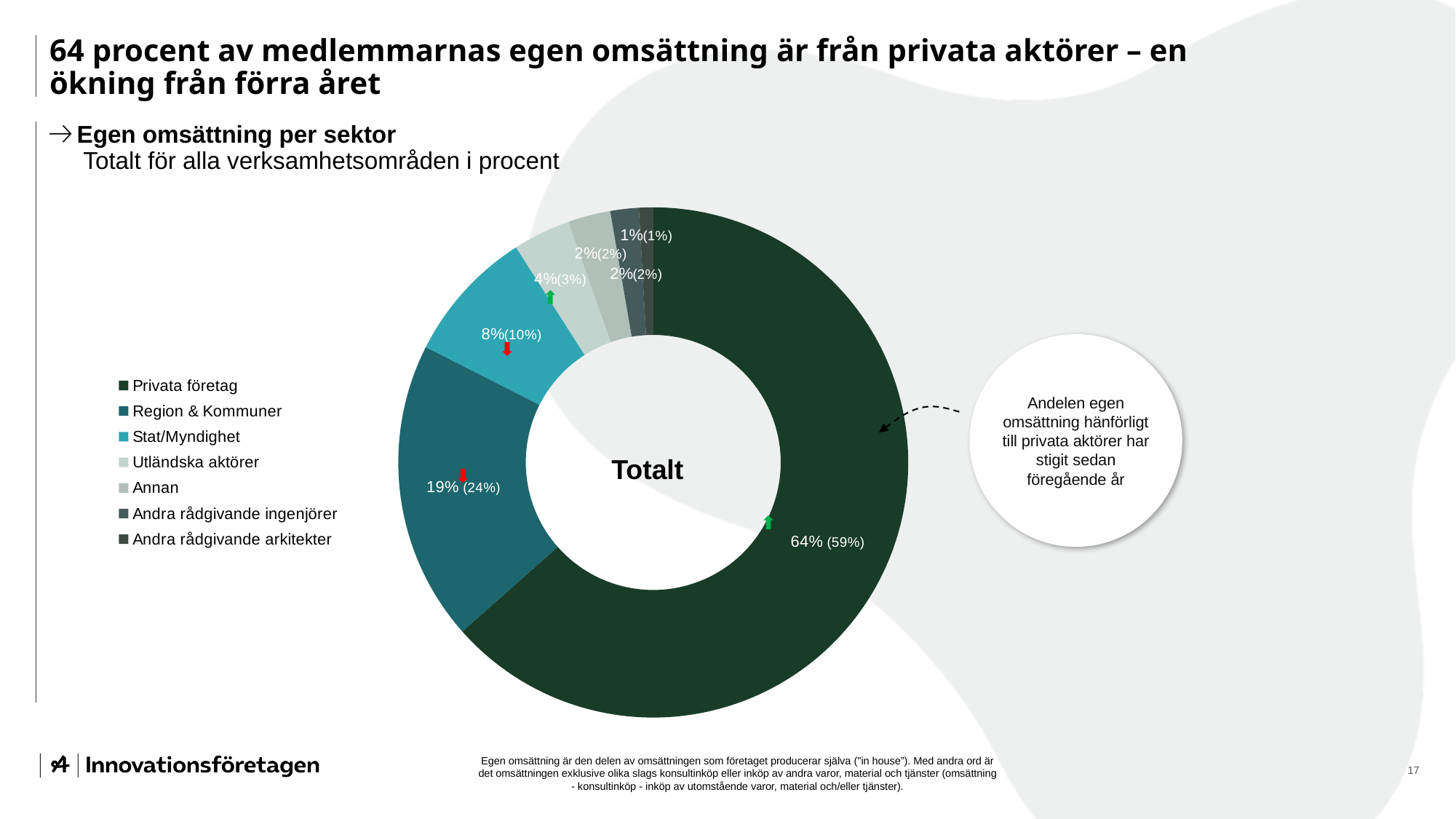
What share of egen omsättning comes from Utländska aktörer? 4% Which sector has the smallest share of egen omsättning? Andra rådgivande arkitekter What was the previous year's share for Privata företag, shown in parentheses? 59% What word is written in the centre of the doughnut chart? Totalt Which sector has the largest share of egen omsättning? Privata företag What share of egen omsättning comes from Privata företag? 64% Which is larger: the share for Stat/Myndighet or the share for Utländska aktörer? Stat/Myndighet What share of egen omsättning comes from Region & Kommuner? 19% How many sectors (categories) does the chart show? 7 What is the difference in percentage points between the shares of Privata företag and Region & Kommuner? 45 percentage points What kind of chart is shown on the slide? Doughnut (pie) chart What share of egen omsättning comes from Stat/Myndighet? 8%